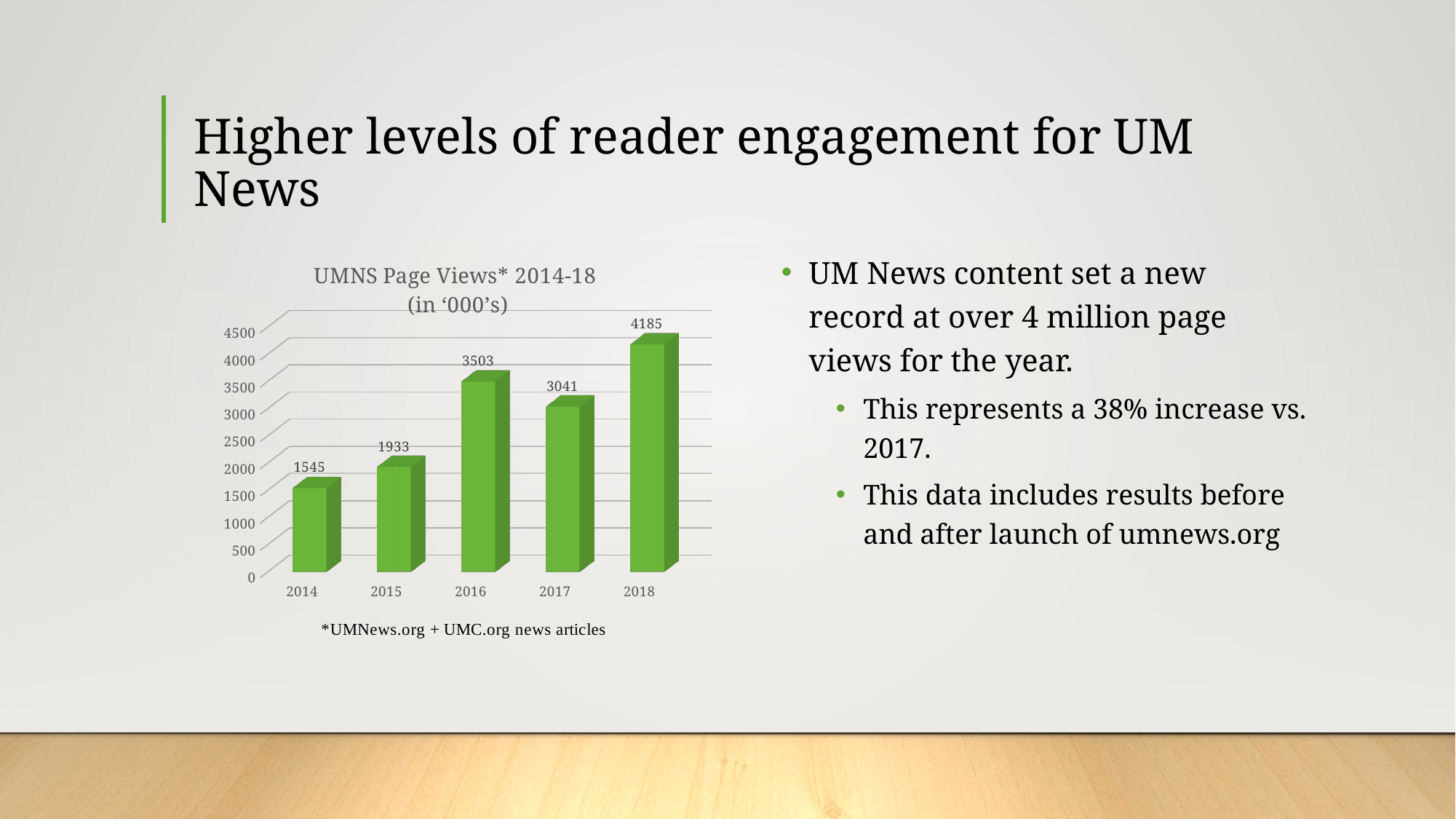
What is the value for 2016? 3503 What is the title of the chart? UMNS Page Views* 2014-18 (in '000's) Which is larger, the value for 2016 or the value for 2017? 2016 What is the difference between the values for 2015 and 2014? 388 Which year has the highest value? 2018 Which year has the lowest value? 2014 What is the value for 2014? 1545 What kind of chart is shown on the slide? bar chart Is the value for 2017 greater or less than 3500? less How many years are shown on the x axis? 5 What is the value for 2018? 4185 What is the difference between the values for 2018 and 2017? 1144